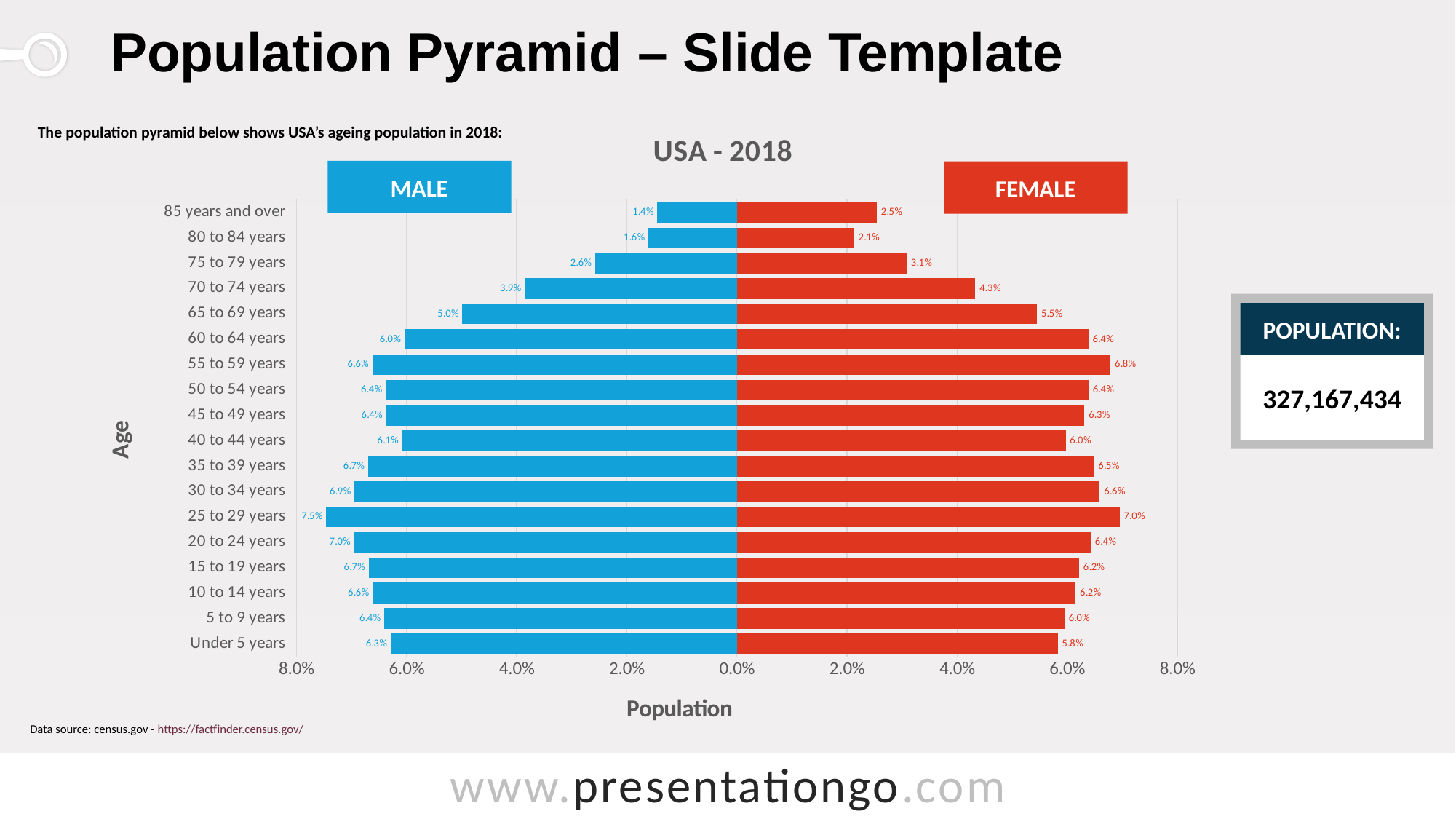
What is the male value for the 25 to 29 years age group? 7.5% Which age group has the highest male value? 25 to 29 years What is the female value for the 85 years and over age group? 2.5% What kind of chart is shown on the slide? Bar chart What is the title of the chart? USA - 2018 What is the female value for the 55 to 59 years age group? 6.8% What is the difference between the male and female values for the 20 to 24 years age group? 0.6% For the 70 to 74 years age group, is the male or the female value larger? Female How many age groups are shown in the chart? 18 Which age group has the lowest male value? 85 years and over Which age group has the lowest female value? 80 to 84 years How many series does the chart show? 2